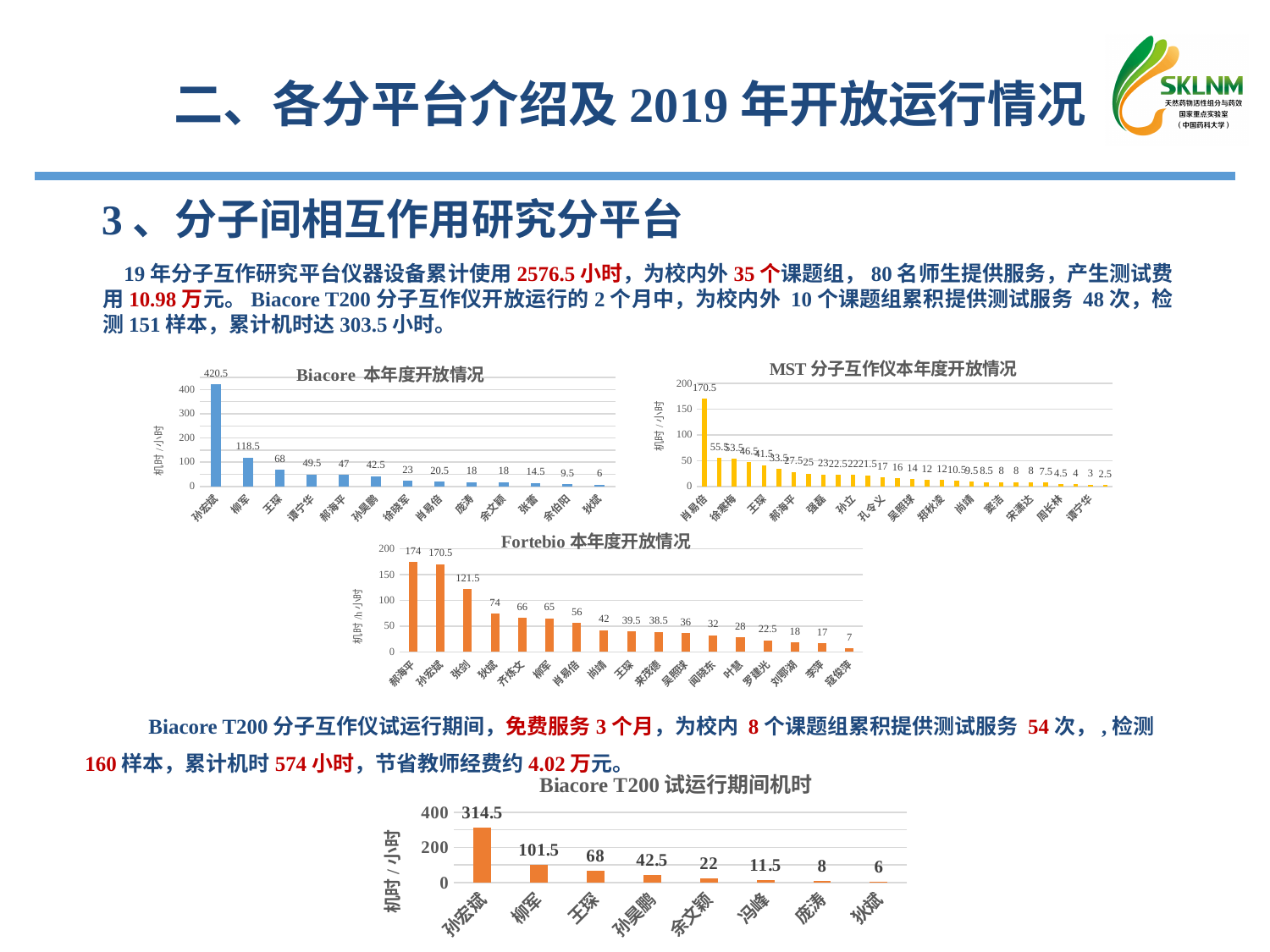
In the 'Biacore T200 试运行期间机时' chart, what is the value for 孙宏斌? 314.5 In the 'Fortebio 本年度开放情况' chart, which is larger, the value for 狄斌 or the value for 柳军? 狄斌 In the 'MST 分子互作仪本年度开放情况' chart, what is the value for 肖易倍? 170.5 In the 'Biacore 本年度开放情况' chart, which category has the lowest value? 狄斌 In the 'Fortebio 本年度开放情况' chart, what is the value for 寇俊萍? 7 In the 'Biacore 本年度开放情况' chart, what is the difference between the values for 柳军 and 王琛? 50.5 In the 'MST 分子互作仪本年度开放情况' chart, which category has the highest value? 肖易倍 In the 'Biacore 本年度开放情况' chart, how many categories are shown on the x axis? 13 In the 'Biacore 本年度开放情况' chart, what is the value for 孙宏斌? 420.5 What kind of chart is the 'Biacore T200 试运行期间机时' chart? bar chart In the 'Fortebio 本年度开放情况' chart, what is the value for 郝海平? 174 In the 'Biacore T200 试运行期间机时' chart, how many categories are shown? 8